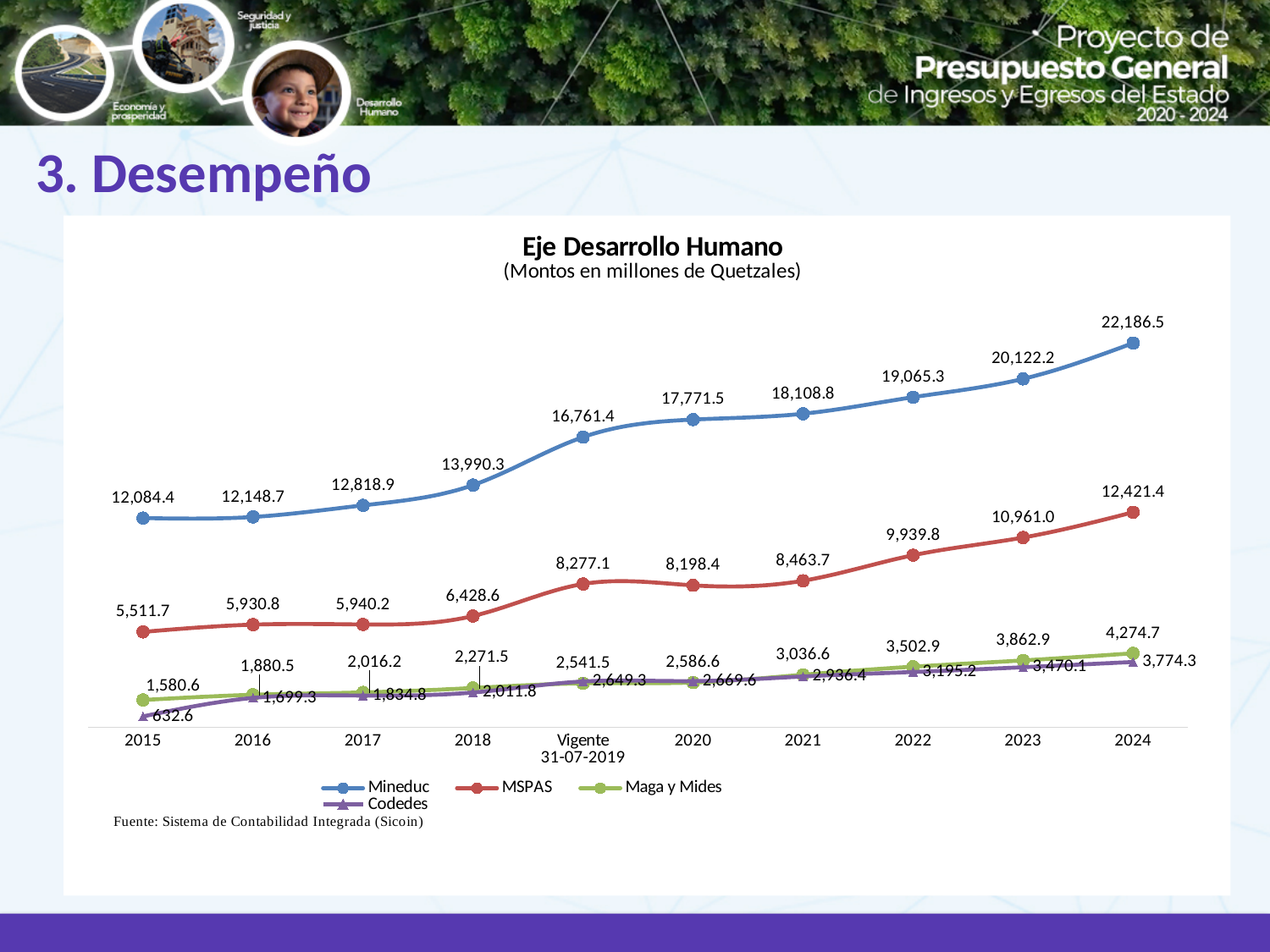
What is the value for Mineduc in 2024? 22,186.5 How many series does the legend list? 4 What is the value for Mineduc at Vigente 31-07-2019? 16,761.4 What is the difference between the Mineduc values in 2024 and 2015? 10,102.1 What is the value for Codedes in 2015? 632.6 What is the value for Maga y Mides in 2022? 3,502.9 In which year is the Mineduc value lowest? 2015 Which is larger: MSPAS in 2018 or MSPAS at Vigente 31-07-2019? Vigente 31-07-2019 How many points are plotted along the x axis for each series? 10 What kind of chart is shown on the slide? Line chart What is the value for MSPAS in 2015? 5,511.7 Which series has the highest value in 2024? Mineduc